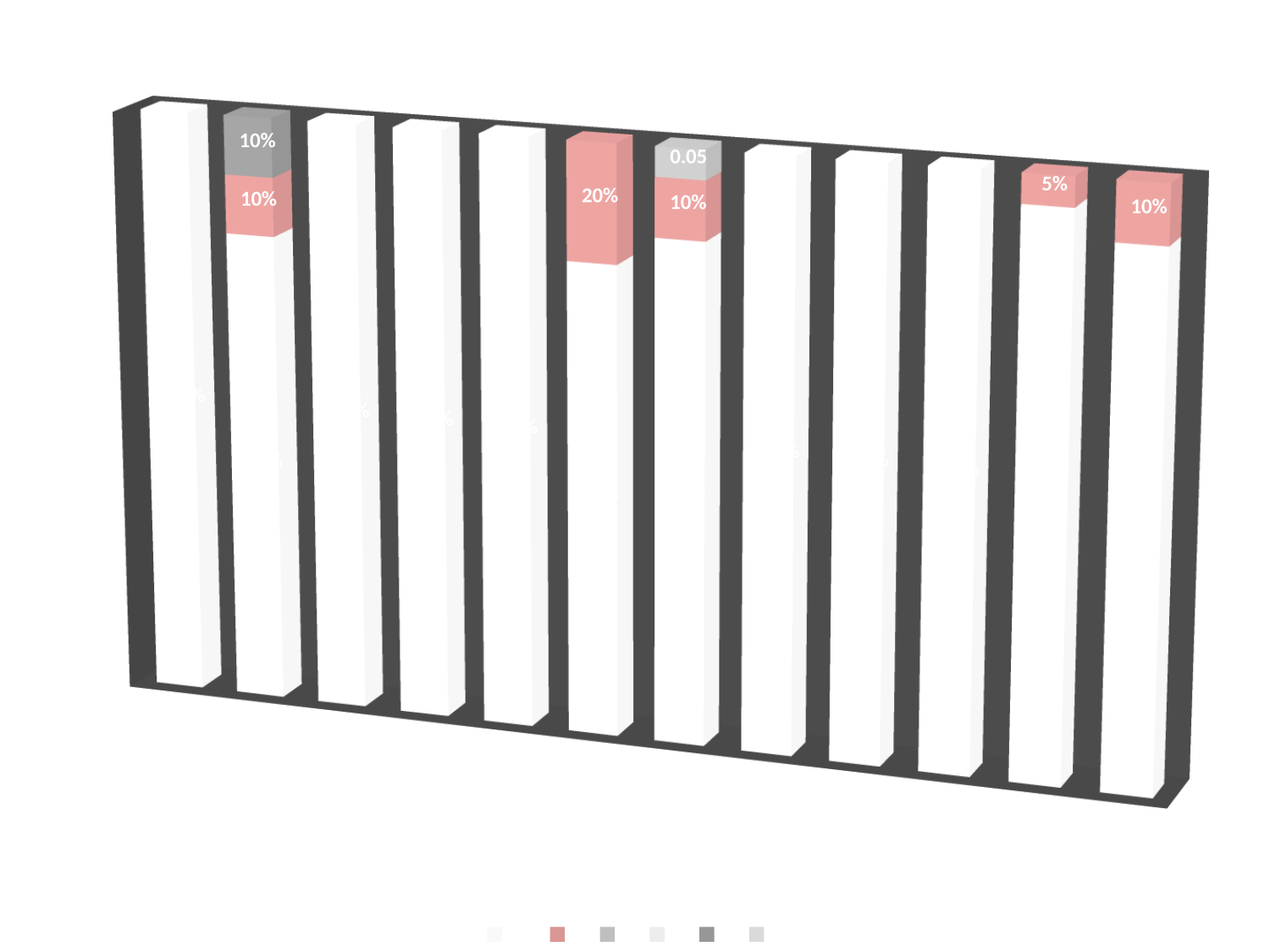
Which bar has the largest labelled pink segment? The sixth bar from the left (20%) How many bars are plotted in the chart? 12 What value is printed on the grey segment at the top of the seventh bar from the left? 0.05 What colour is the segment labelled 20%? Pink What value is printed on the grey segment at the top of the second bar from the left? 10% What value is printed on the pink segment of the sixth bar from the left? 20% What value is printed on the pink segment of the eleventh bar from the left? 5% What kind of chart is shown on the slide? Bar chart How many series does the legend list? 6 What is the difference between the pink segment of the sixth bar (20%) and the pink segment of the eleventh bar (5%)? 15% What value is printed on the pink segment of the rightmost bar? 10% Which is larger, the pink segment of the sixth bar (20%) or the pink segment of the eleventh bar (5%)? The sixth bar